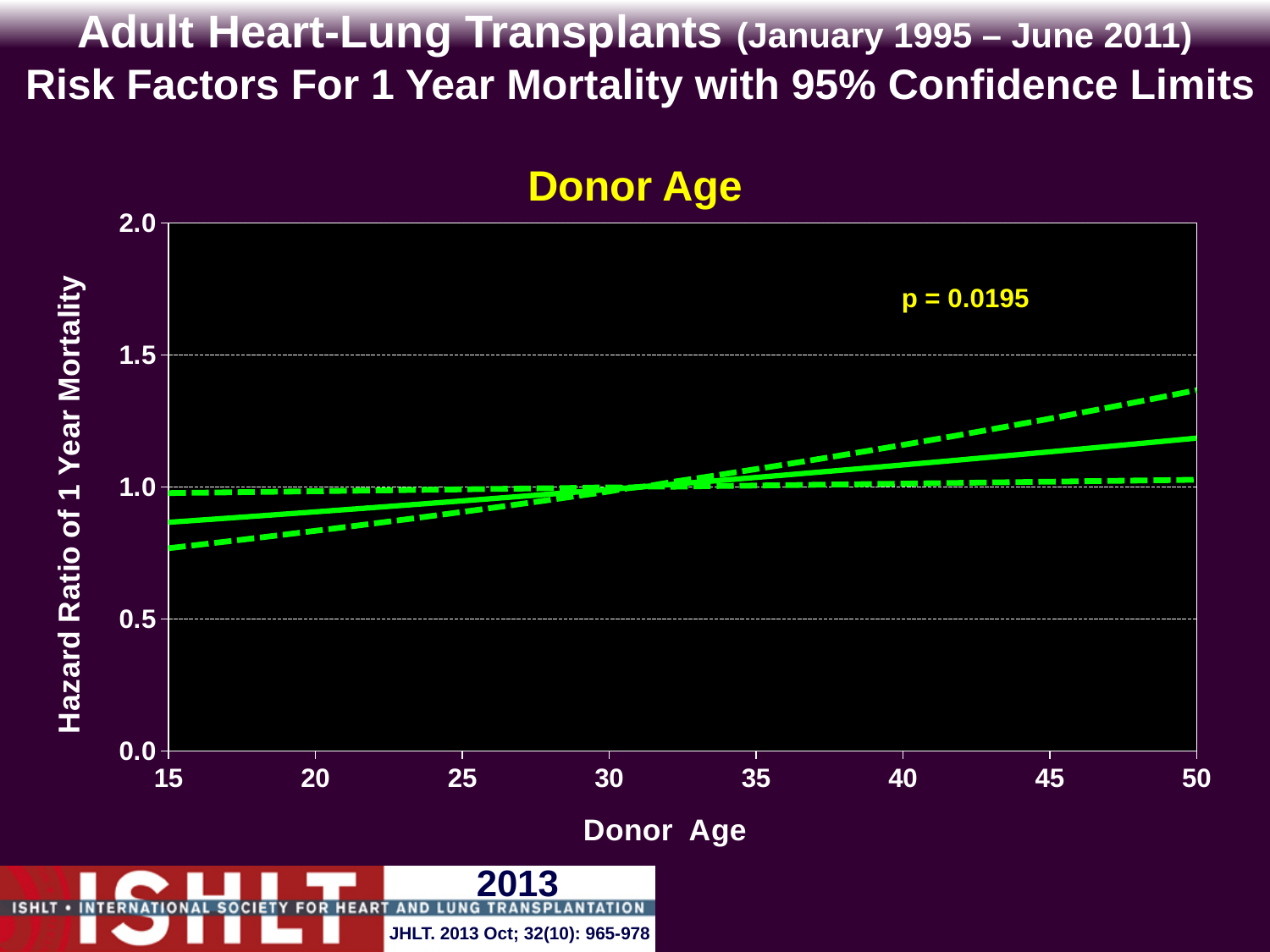
What is the title of the chart? Donor Age Is the lower confidence limit (lower dashed line) at donor age 15 greater or less than 0.5? greater What kind of chart is shown on the slide? Line chart How many tick labels are shown on the Donor Age (x) axis? 8 Is the hazard ratio (solid line) at donor age 15 greater or less than 1.0? less How many lines are plotted on the chart? 3 Does the hazard ratio (solid line) rise or fall as donor age increases from 15 to 50? Rise Which is larger, the hazard ratio (solid line) at donor age 15 or at donor age 50? Donor age 50 Is the hazard ratio (solid line) at donor age 50 greater or less than 1.0? greater What p-value is printed on the chart? p = 0.0195